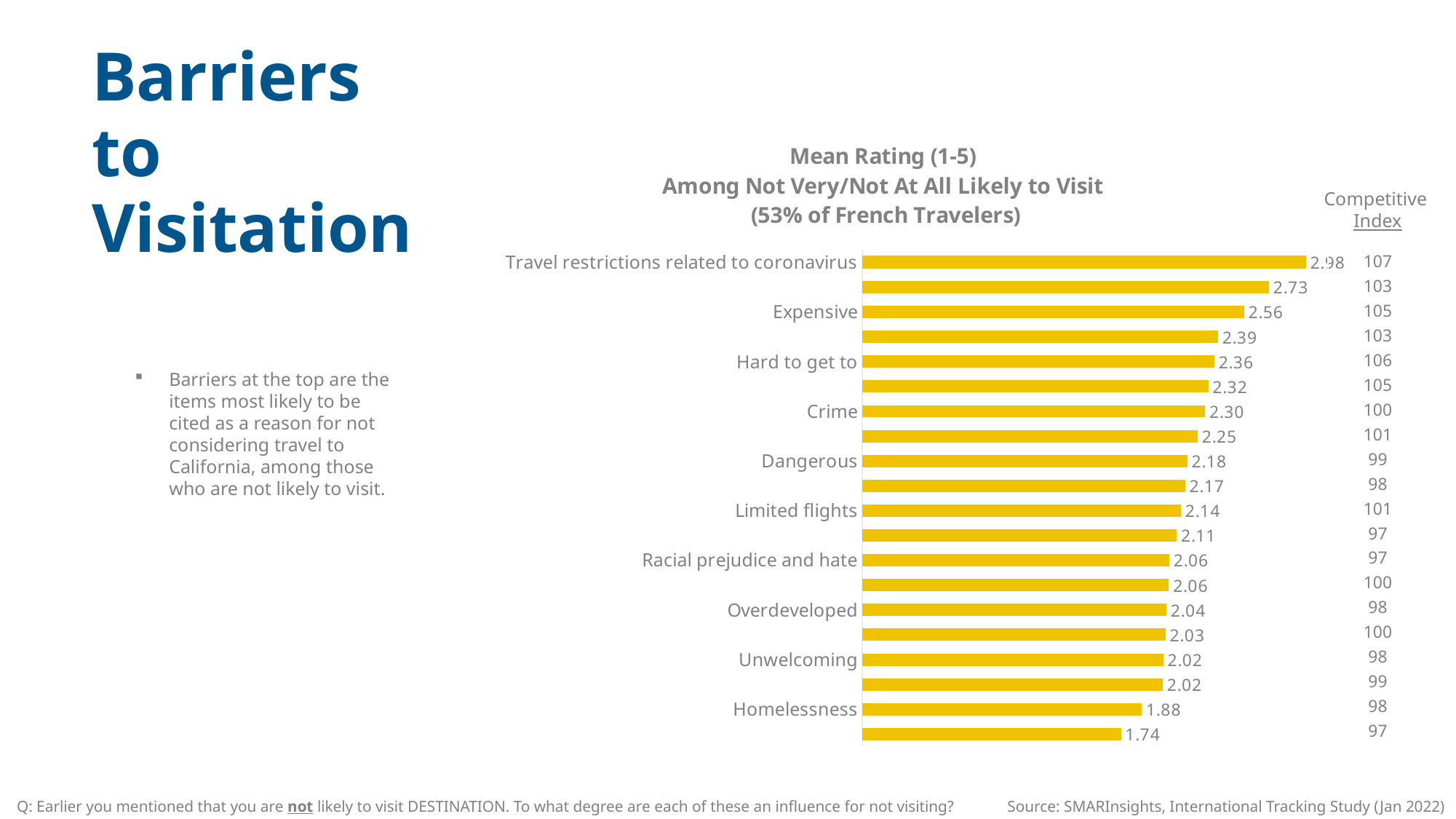
What is the difference between the mean ratings for Crime and Homelessness? 0.42 What is the mean rating for Crime? 2.30 How many bars are plotted on the chart? 20 What is the lowest mean rating shown on the chart? 1.74 Do the mean ratings increase or decrease going from the top bar to the bottom bar? Decrease What is the Competitive Index value listed for Expensive? 105 Which barrier has the highest mean rating? Travel restrictions related to coronavirus Which has a higher mean rating, Dangerous or Limited flights? Dangerous What is the mean rating for Homelessness? 1.88 What is the difference between the mean ratings for Expensive and Hard to get to? 0.20 What is the mean rating for Expensive? 2.56 What type of chart is shown on the slide? Bar chart